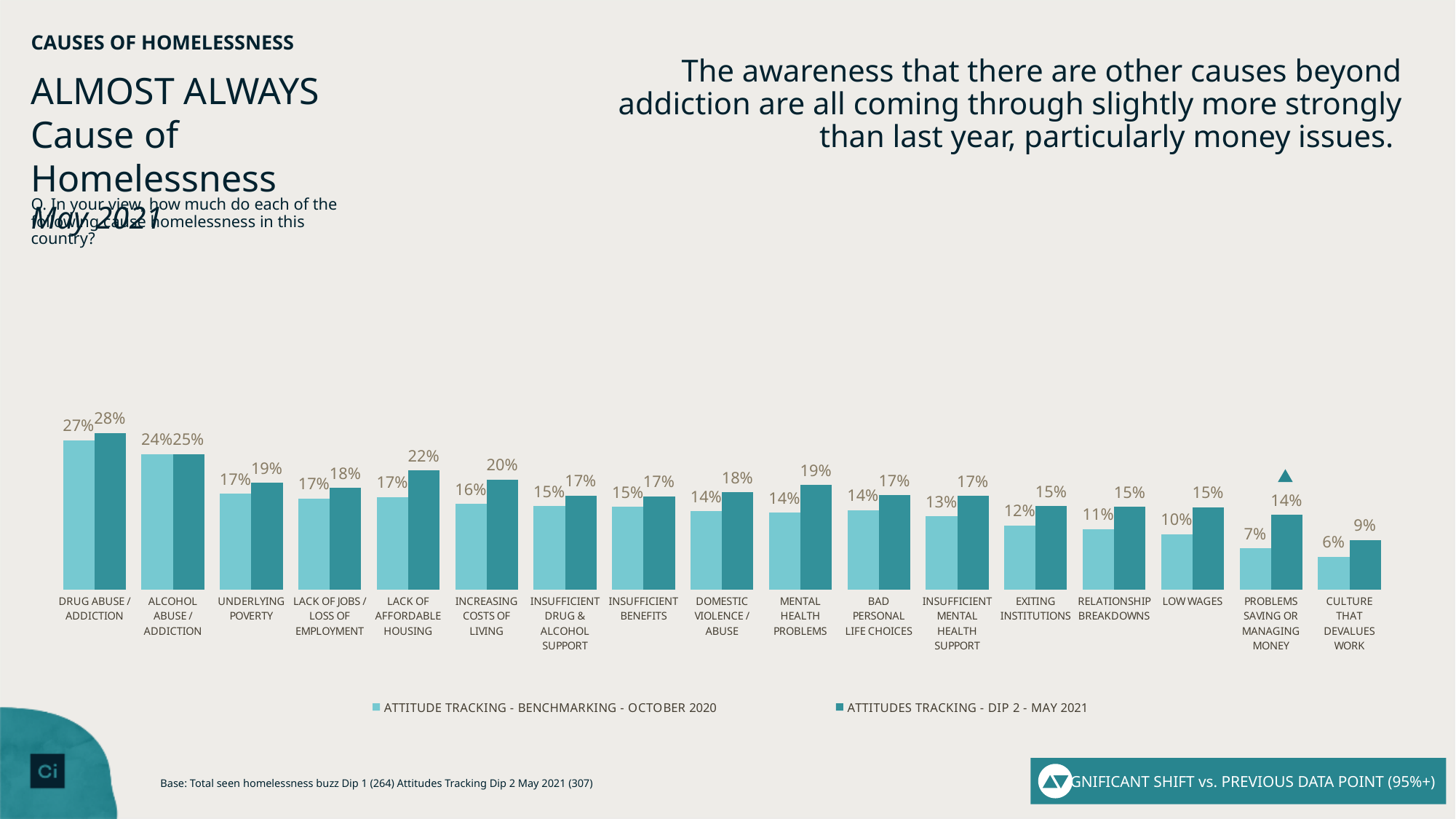
Which is larger: the May 2021 value for Increasing Costs of Living or the May 2021 value for Low Wages? Increasing Costs of Living How many series does the legend list? 2 Which category is marked with a triangle indicating a significant shift vs. the previous data point? Problems Saving or Managing Money What is the difference between the May 2021 and October 2020 values for Problems Saving or Managing Money? 7% What is the October 2020 value for Problems Saving or Managing Money? 7% Which category has the highest May 2021 value? Drug Abuse / Addiction What is the May 2021 value for Lack of Affordable Housing? 22% What kind of chart is shown on the slide? Bar chart How many categories are shown on the x axis of the chart? 17 What is the May 2021 value for Mental Health Problems? 19% Which category has the lowest October 2020 value? Culture That Devalues Work What is the difference between the May 2021 values for Drug Abuse / Addiction and Alcohol Abuse / Addiction? 3%